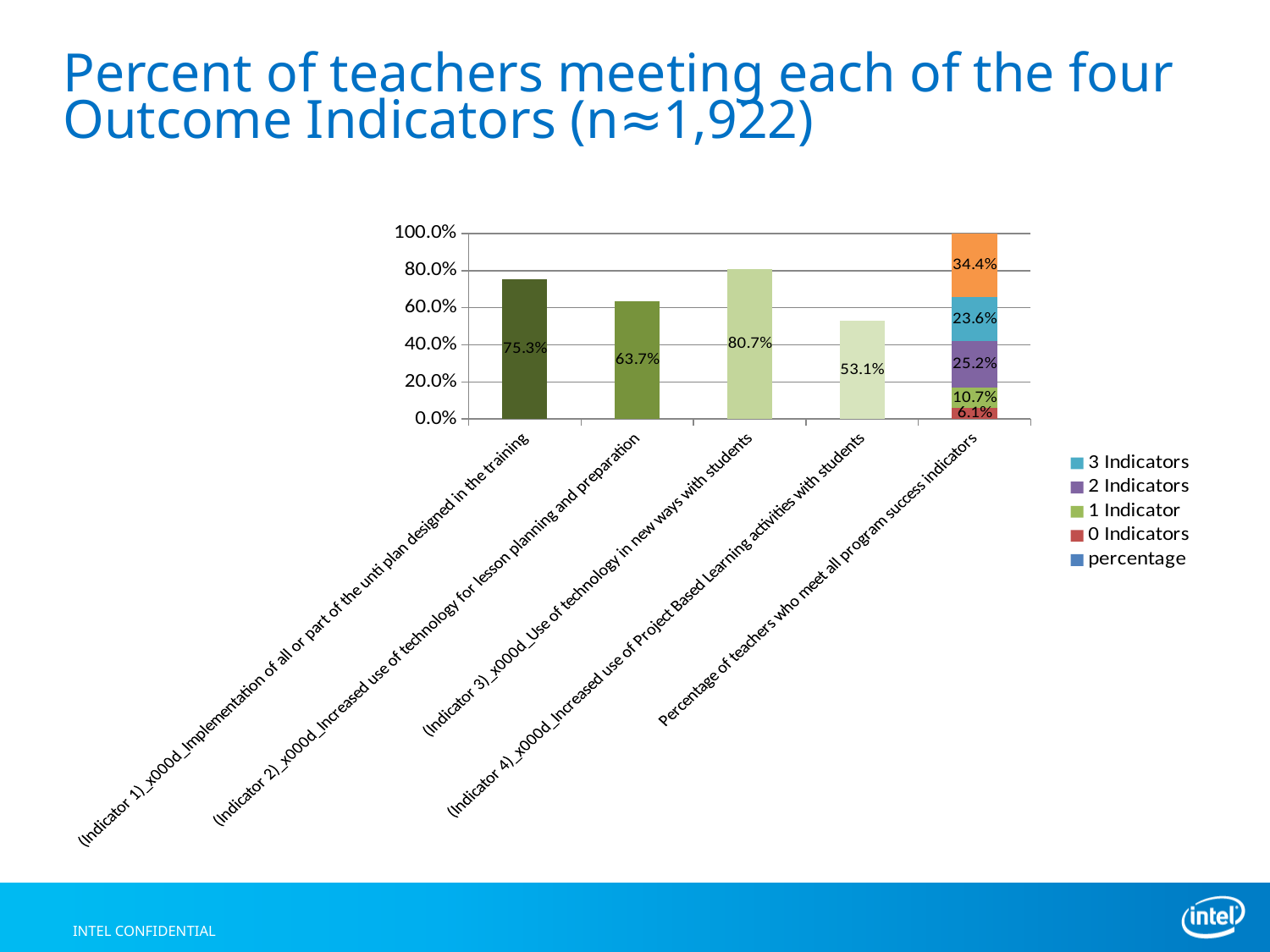
In the stacked bar for teachers who meet all program success indicators, what is the value of the 0 Indicators segment? 6.1% What is the difference in percentage points between Indicator 3 (80.7%) and Indicator 4 (53.1%)? 27.6 percentage points Which of the four Outcome Indicators has the highest percentage of teachers meeting it? Indicator 3 (Use of technology in new ways with students) What percentage of teachers met Indicator 1 (Implementation of all or part of the unit plan designed in the training)? 75.3% What kind of chart is shown on the slide? Bar chart How many entries does the legend list? 5 In the stacked bar for teachers who meet all program success indicators, what is the value of the 2 Indicators segment? 25.2% What percentage of teachers met Indicator 3 (Use of technology in new ways with students)? 80.7% What is the total of all segments in the stacked bar for teachers who meet all program success indicators? 100.0% Which has a higher percentage of teachers: Indicator 1 or Indicator 2? Indicator 1 Which of the four Outcome Indicators has the lowest percentage of teachers meeting it? Indicator 4 (Increased use of Project Based Learning activities with students) What percentage of teachers met Indicator 4 (Increased use of Project Based Learning activities with students)? 53.1%